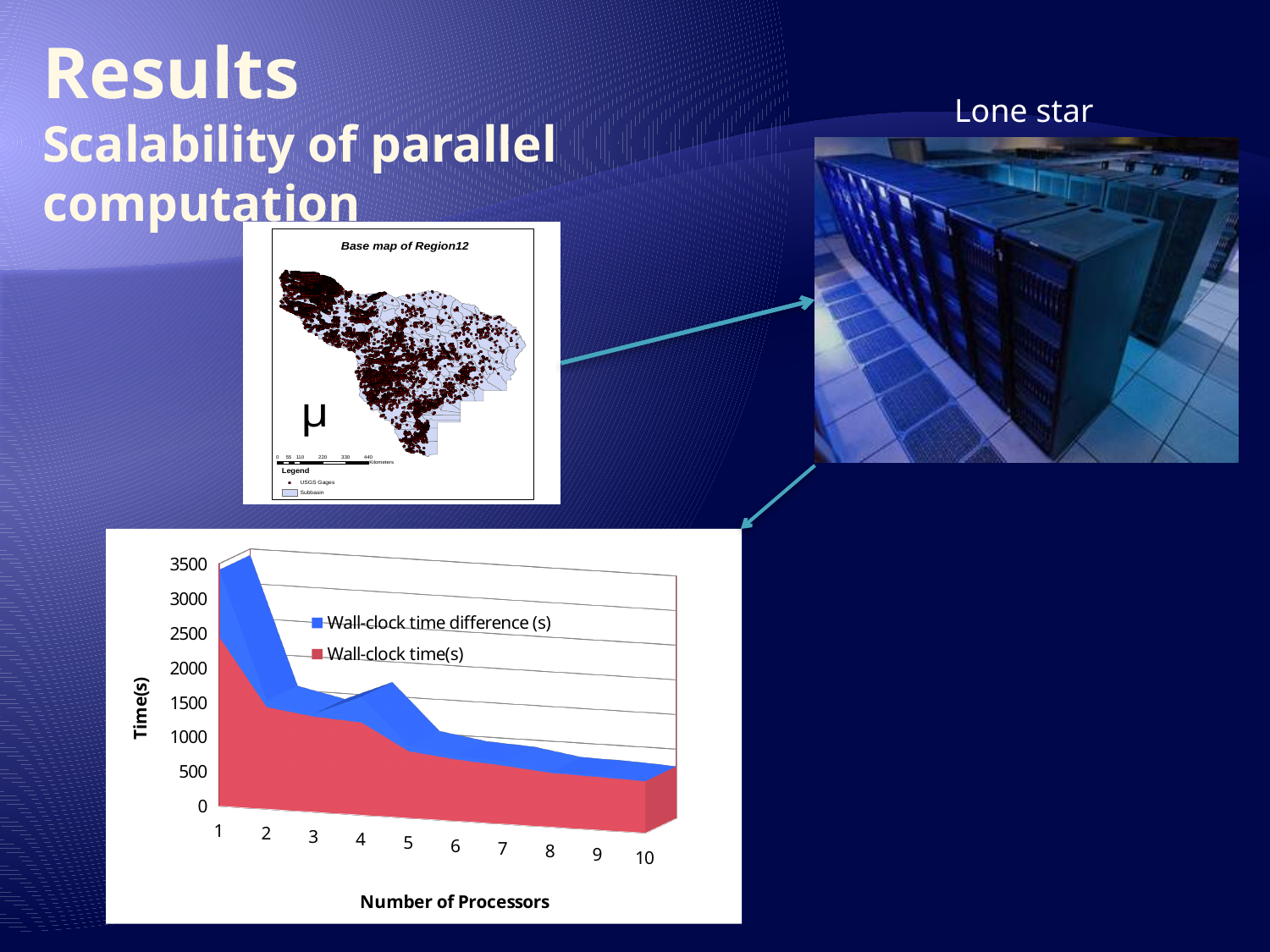
How many processor counts are plotted along the x axis of the chart? 10 Does the wall-clock time rise or fall as the number of processors increases? fall Which number of processors has the highest Wall-clock time(s)? 1 What kind of chart is shown on the slide? area chart Is the Wall-clock time(s) value for 10 processors greater or less than 1000? less Is the Wall-clock time(s) value for 1 processor greater or less than 2000? greater Which number of processors has the lowest Wall-clock time(s)? 10 What is the label of the chart's x axis? Number of Processors How many series does the chart legend list? 2 What colour represents the Wall-clock time(s) series in the chart? red Is the Wall-clock time(s) value for 8 processors greater or less than 1500? less